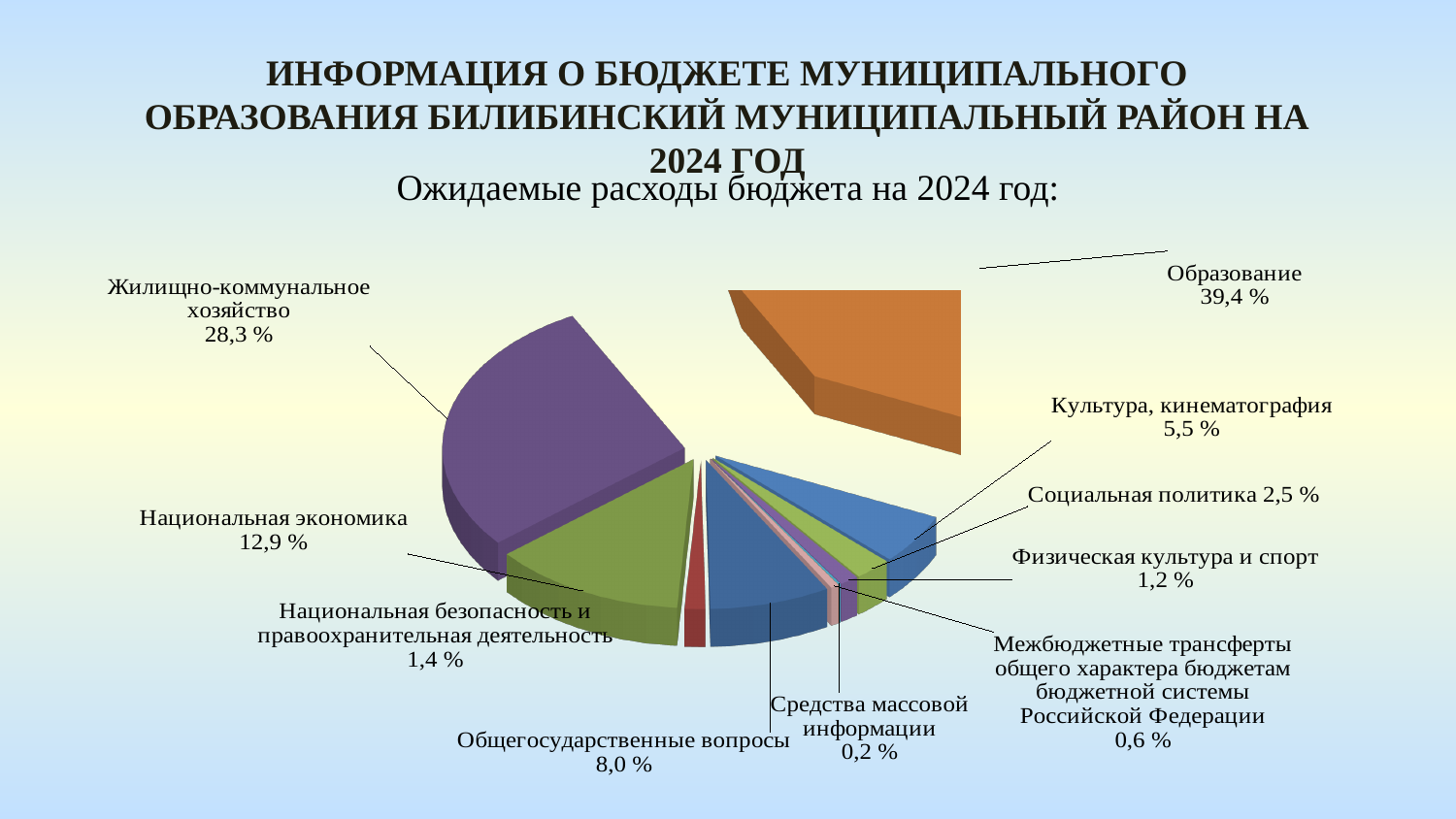
What is the difference between Общегосударственные вопросы and Культура, кинематография? 2,5 % What is the value shown for Жилищно-коммунальное хозяйство? 28,3 % What is the value for Средства массовой информации? 0,2 % Which is larger: Культура, кинематография or Социальная политика? Культура, кинематография What percentage is labelled for Национальная экономика? 12,9 % What share of expected 2024 budget expenditures goes to Образование? 39,4 % How many categories are shown in the pie chart? 10 Which category has the largest share of the pie? Образование What type of chart is shown on the slide? Pie chart What is the difference between the shares of Образование and Жилищно-коммунальное хозяйство? 11,1 % What is the subtitle of the chart on the slide? Ожидаемые расходы бюджета на 2024 год: Which category has the smallest share of the pie? Средства массовой информации